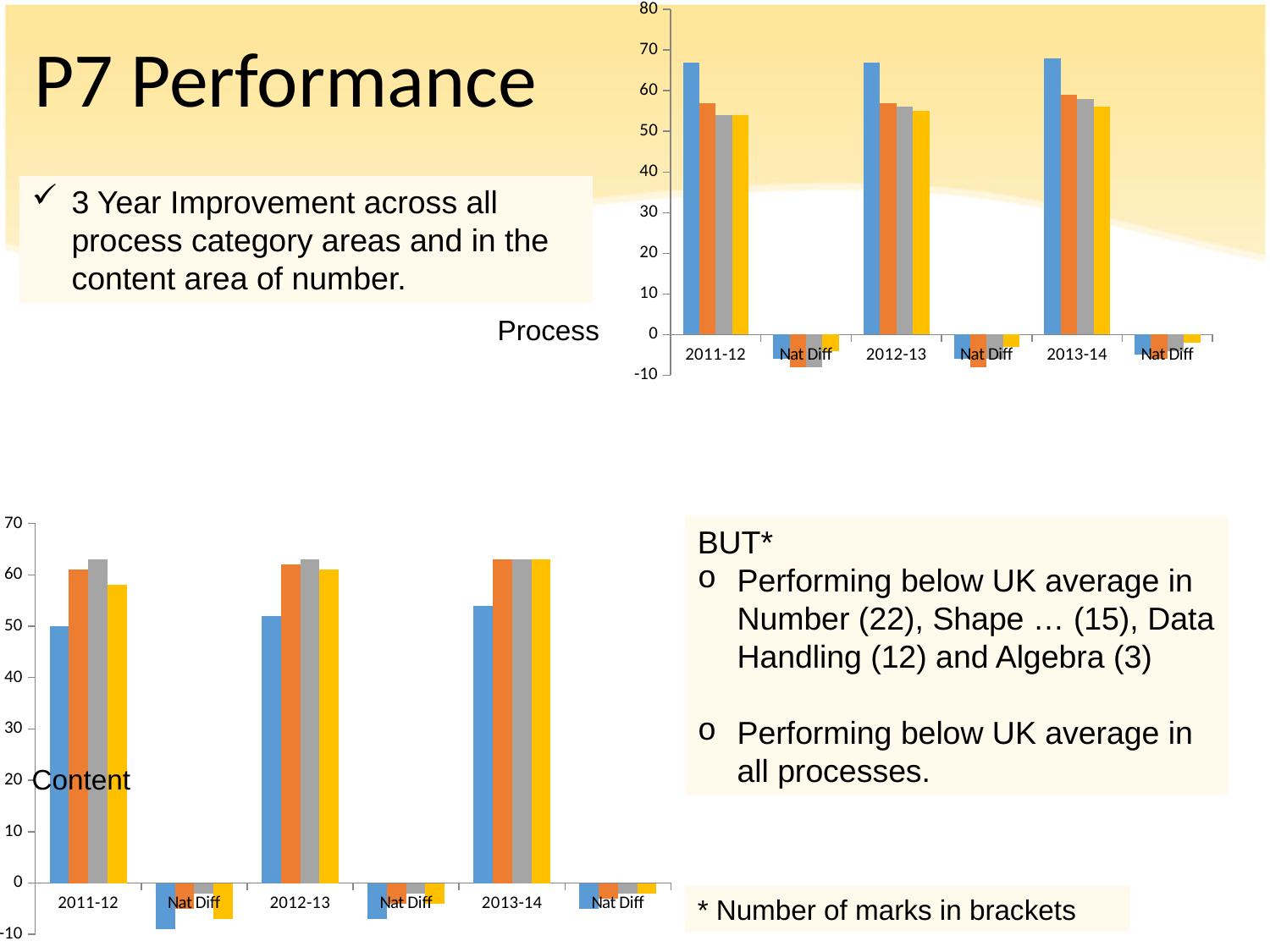
In the Content chart, is the value of the grey bar for 2011-12 greater or less than 60? greater What is the highest value shown on the y axis of the Process chart? 80 What kind of chart is the Process chart? bar chart What kind of chart is the Content chart? bar chart In the Content chart, do the blue bars rise or fall from 2011-12 to 2013-14? rise In the Process chart, is the value of the blue bar for 2011-12 greater or less than 60? greater In the Content chart, is the value of the blue bar for 2011-12 greater or less than 60? less How many categories are shown on the x axis of the Process chart? 6 How many categories are shown on the x axis of the Content chart? 6 In the Process chart, which is larger for 2011-12, the blue bar or the orange bar? the blue bar